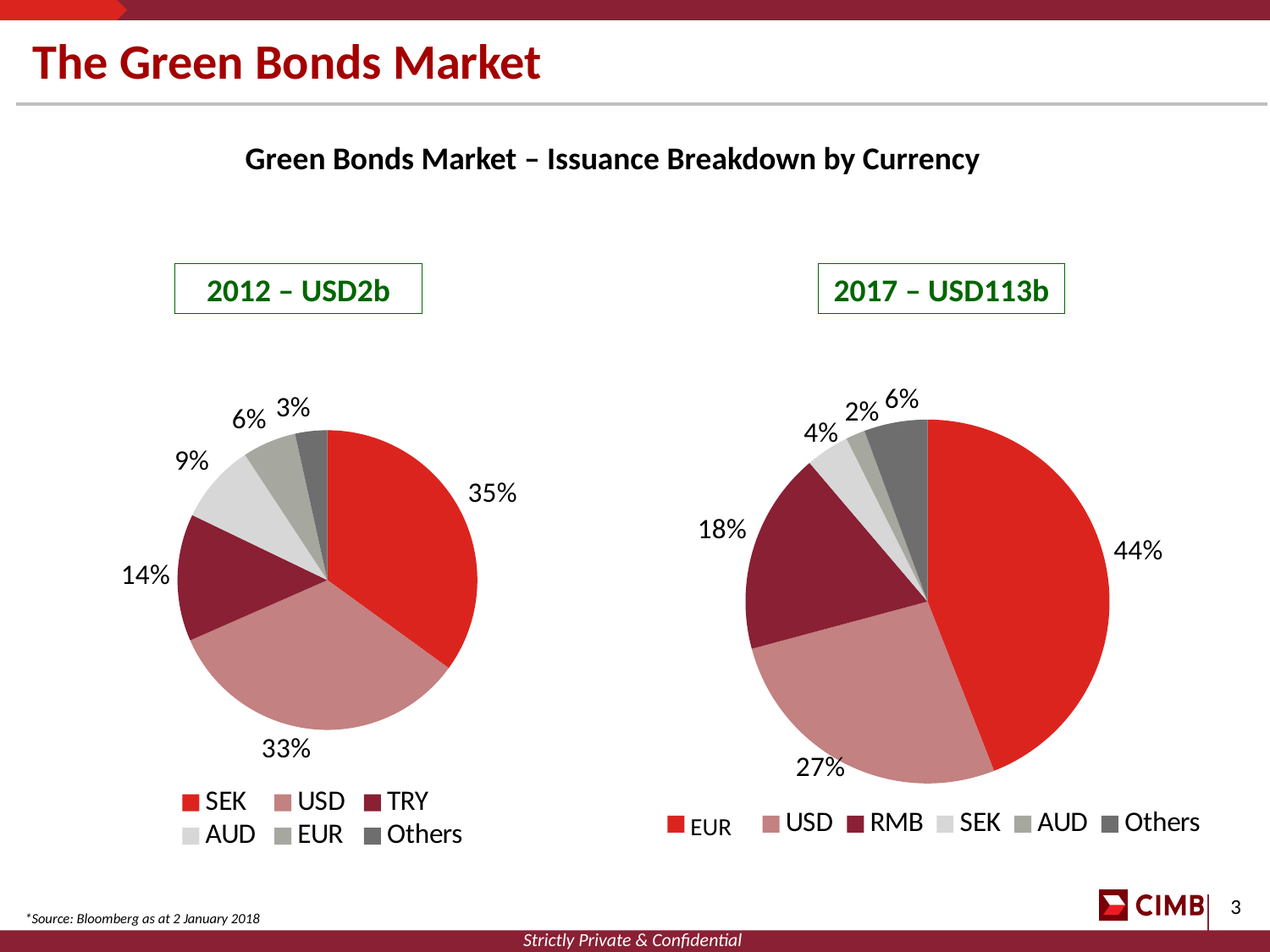
In the 2017 – USD113b pie chart, which currency has the largest share? EUR In the 2012 – USD2b pie chart, what share does SEK have? 35% In the 2012 – USD2b pie chart, which currency has the smallest share? Others In the 2017 – USD113b pie chart, what share does EUR have? 44% How many currency categories does the legend of the 2012 – USD2b pie chart list? 6 In the 2017 – USD113b pie chart, which currency has the smallest share? AUD What type of chart is used for the 2017 – USD113b breakdown? Pie chart What is the title shown above the two charts? Green Bonds Market – Issuance Breakdown by Currency In the 2017 – USD113b pie chart, which is larger, the USD share or the RMB share? USD In the 2012 – USD2b pie chart, what is the difference between the SEK share and the USD share? 2% In the 2012 – USD2b pie chart, what share does TRY have? 14% In the 2017 – USD113b pie chart, what share does RMB have? 18%